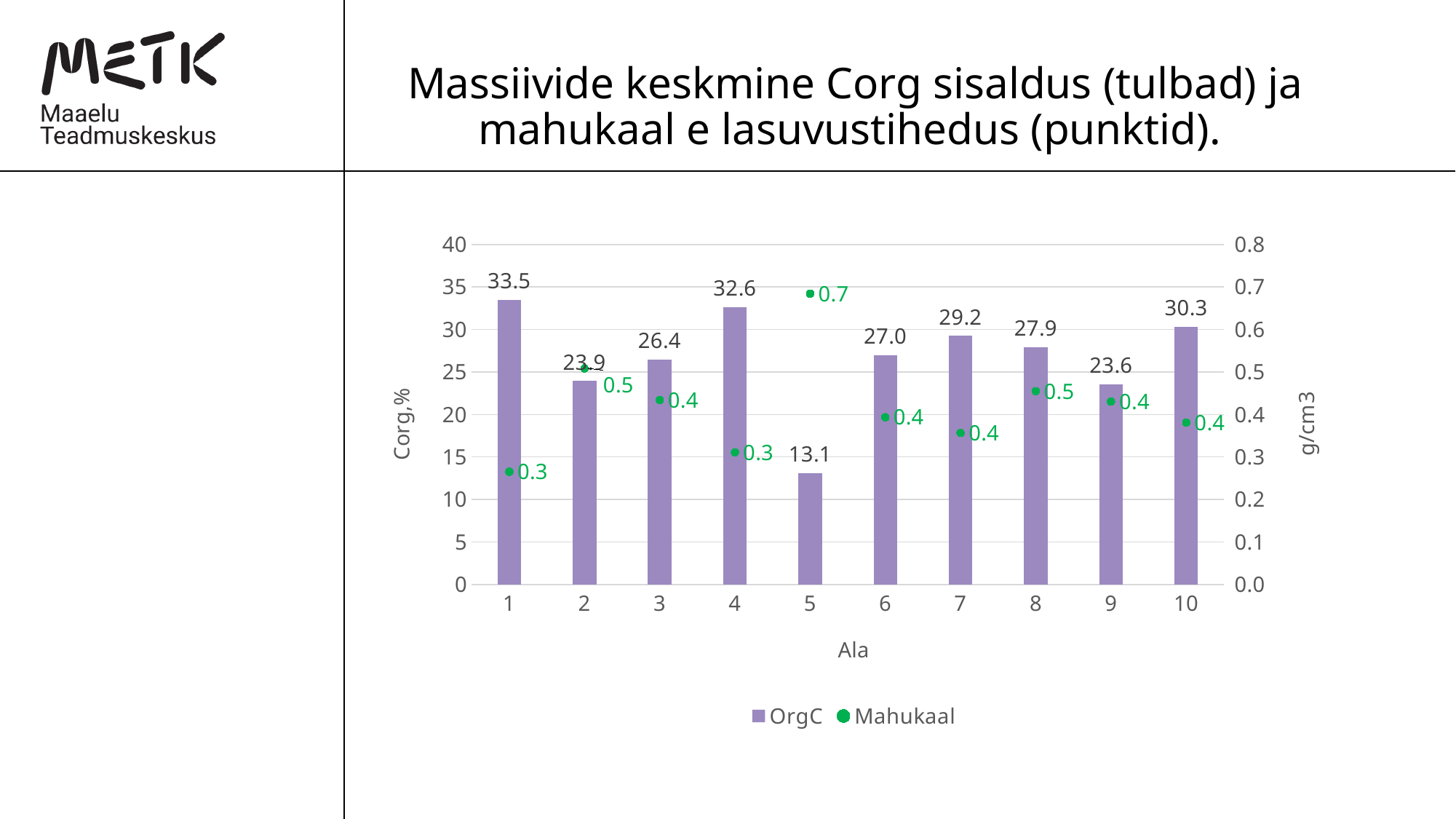
Which has a larger OrgC value, Ala 4 or Ala 7? Ala 4 What is the difference between the OrgC values for Ala 1 and Ala 5? 20.4 What kind of chart is used to show the OrgC values? Bar chart Which Ala has the highest Mahukaal value? 5 How many series does the legend list? 2 Which Ala has the highest OrgC value? 1 Which Ala has the lowest OrgC value? 5 What is the label of the right-hand vertical axis? g/cm3 What is the OrgC value for Ala 10? 30.3 How many Ala categories are shown on the x axis? 10 What is the OrgC value for Ala 1? 33.5 What is the Mahukaal value for Ala 5? 0.7